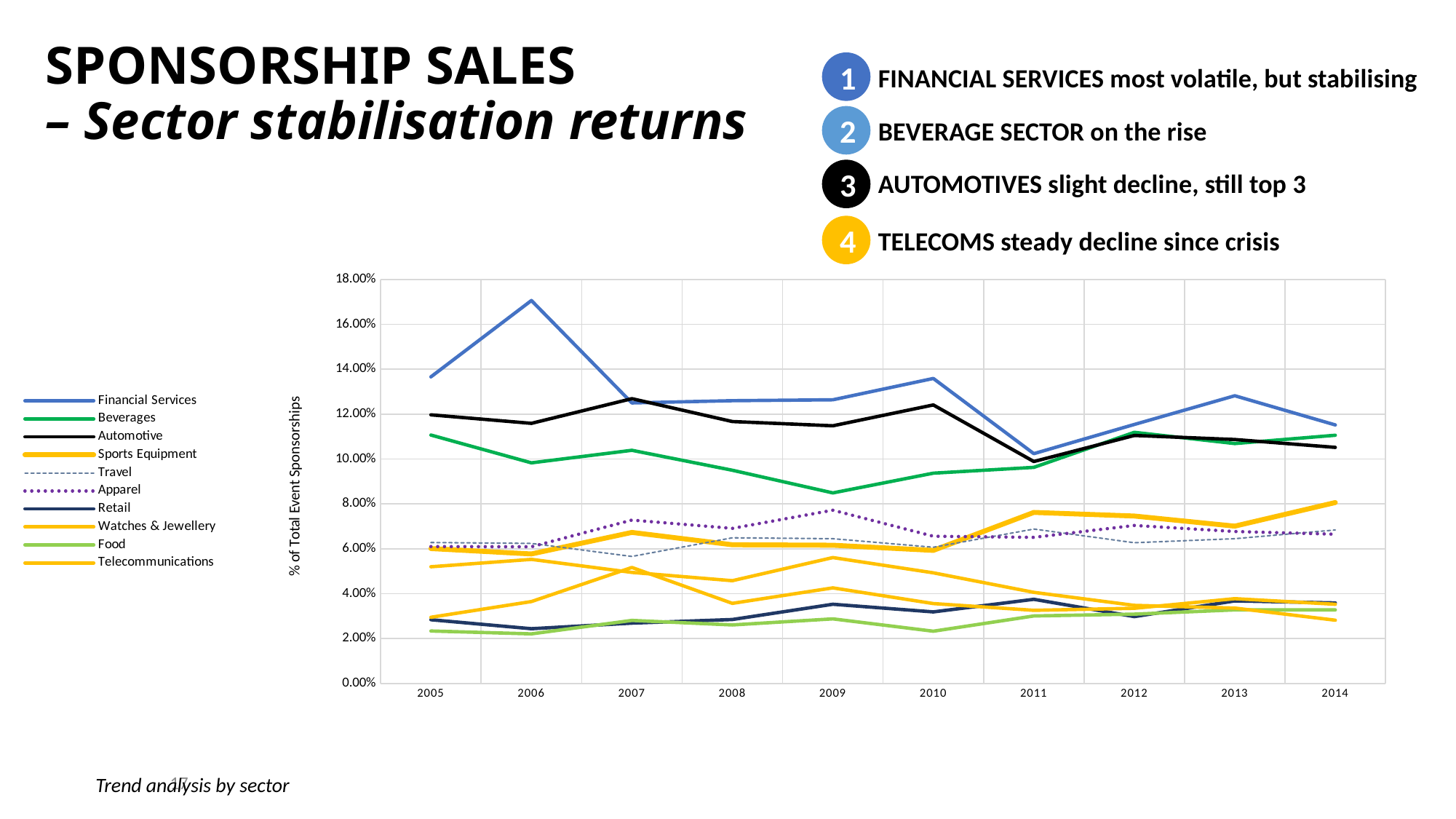
How many series does the chart's legend list? 10 What is the title of the chart's y axis? % of Total Event Sponsorships Is the value for Beverages in 2009 greater or less than 10.00%? less Is the value for Financial Services in 2006 greater or less than 16.00%? greater Is the value for Financial Services in 2011 greater or less than 12.00%? less In 2005, which is larger: Automotive or Beverages? Automotive Which sector has the highest value in 2006? Financial Services What kind of chart is shown on the slide? line chart Does the Telecommunications line rise or fall from 2009 to 2014? fall How many years are plotted along the x axis of the chart? 10 Which series is drawn as a dotted purple line in the legend? Apparel Which sector has the lowest value in 2010? Food